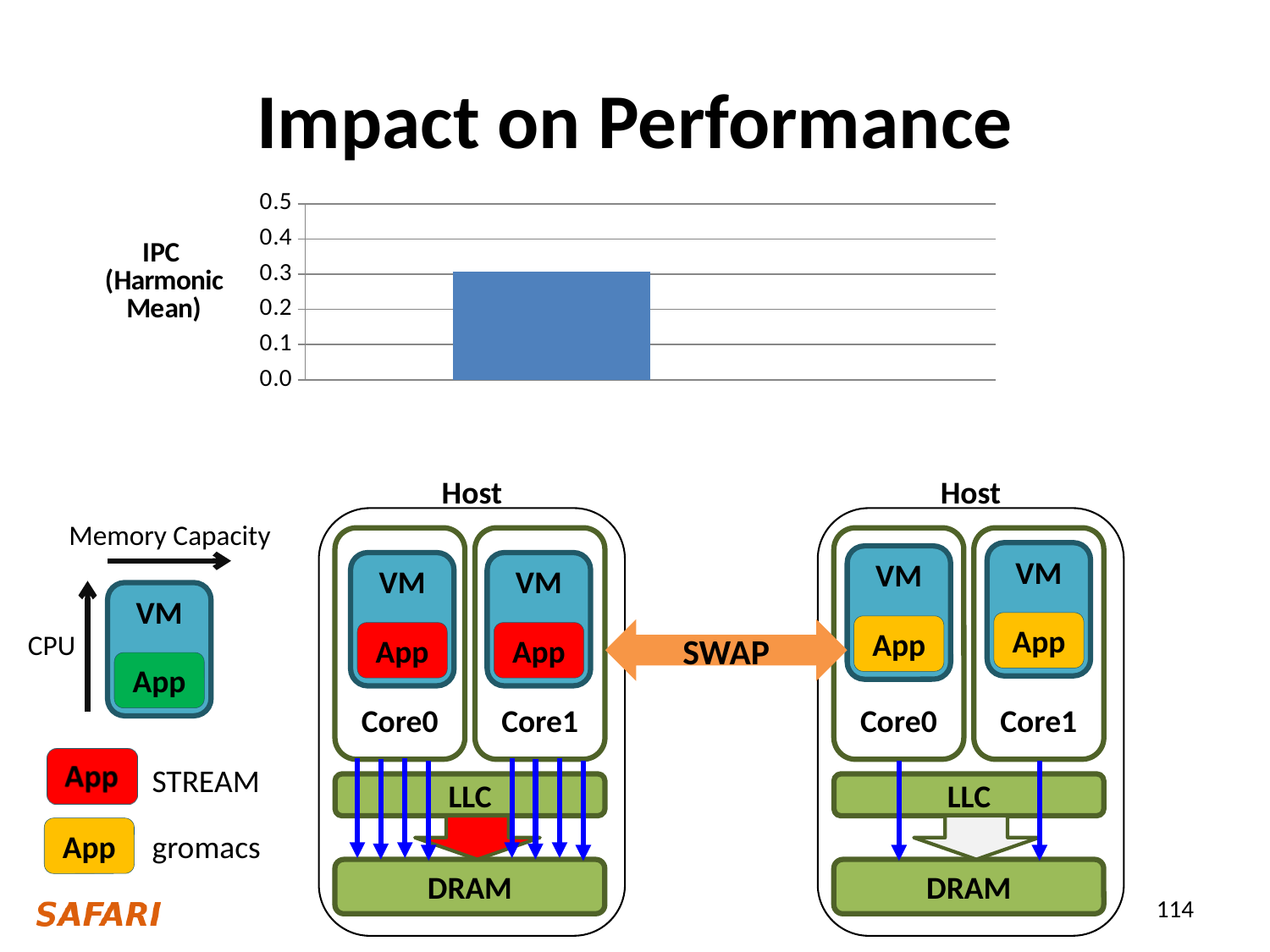
How many bars are plotted in the chart? 1 Is the value of the bar in the chart greater or less than 0.4? less What is the highest tick value shown on the vertical axis of the chart? 0.5 Is the value of the bar in the chart greater or less than 0.1? greater Is the value of the bar in the chart greater or less than 0.2? greater What kind of chart is shown on the slide? bar chart What is the label of the vertical axis of the chart? IPC (Harmonic Mean)